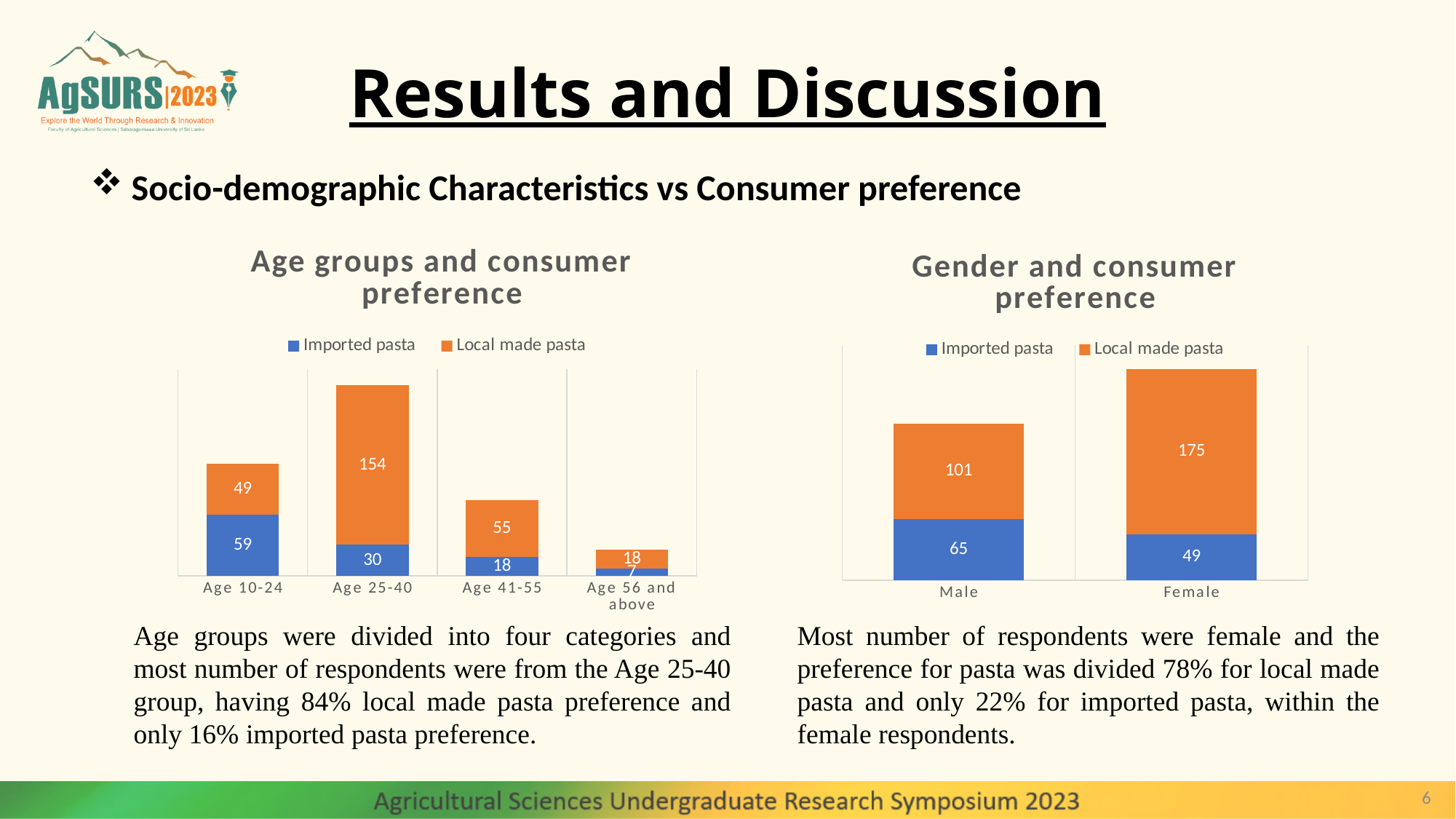
In the 'Age groups and consumer preference' chart, what is the total of the stacked bar for Age 41-55? 73 In the 'Age groups and consumer preference' chart, which age group has the lowest Imported pasta value? Age 56 and above In the 'Gender and consumer preference' chart, how many series does the legend list? 2 In the 'Age groups and consumer preference' chart, what is the difference between Local made pasta and Imported pasta for Age 25-40? 124 What type of chart is the 'Gender and consumer preference' chart? Stacked bar chart In the 'Age groups and consumer preference' chart, what is the value for Imported pasta in the Age 10-24 group? 59 In the 'Gender and consumer preference' chart, what is the total of the stacked bar for Male? 166 In the 'Gender and consumer preference' chart, which gender has the larger Imported pasta value? Male In the 'Age groups and consumer preference' chart, which age group has the highest Local made pasta value? Age 25-40 In the 'Gender and consumer preference' chart, what is the value for Local made pasta for Female? 175 In the 'Age groups and consumer preference' chart, how many age groups are shown? 4 In the 'Age groups and consumer preference' chart, what is the value for Local made pasta in the Age 25-40 group? 154